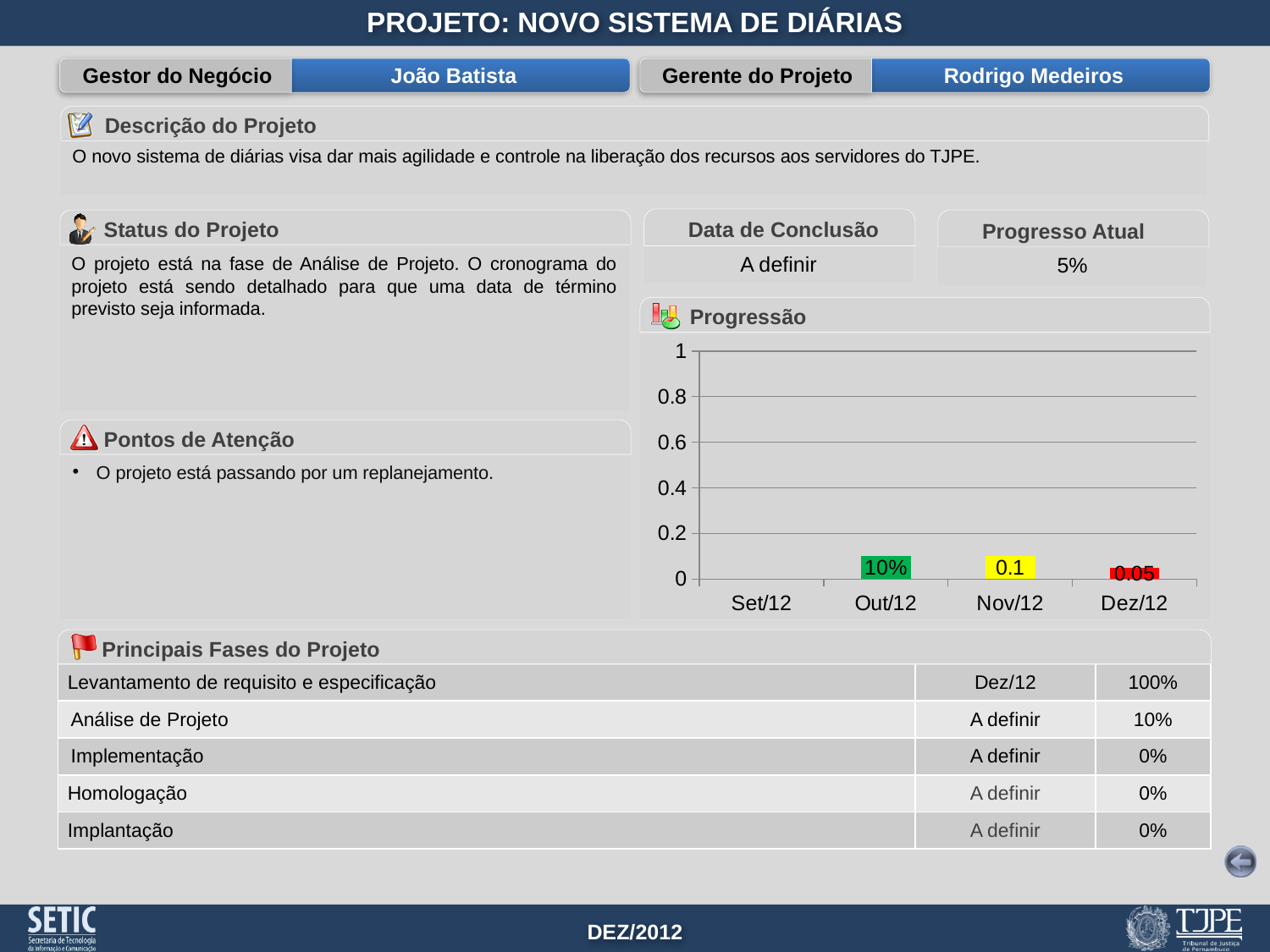
In the Progressão chart, what is the difference between the value for Nov/12 (0.1) and the value for Dez/12 (0.05)? 0.05 What type of chart is shown under the heading "Progressão"? bar chart How many categories are shown on the x axis of the Progressão chart? 4 In the Progressão chart, what colour is the bar for Dez/12? red In the Progressão chart, which is larger, the value for Nov/12 or the value for Dez/12? Nov/12 In the Progressão chart, does the value rise or fall from Nov/12 to Dez/12? fall What is the title of the chart on the slide? Progressão In the Progressão chart, is the value for Nov/12 greater or less than 0.4? less In the Progressão chart, what is the data label shown for Dez/12? 0.05 In the Progressão chart, what is the data label shown for Out/12? 10% In the Progressão chart, is the value for Dez/12 greater or less than 0.2? less In the Progressão chart, what is the data label shown for Nov/12? 0.1